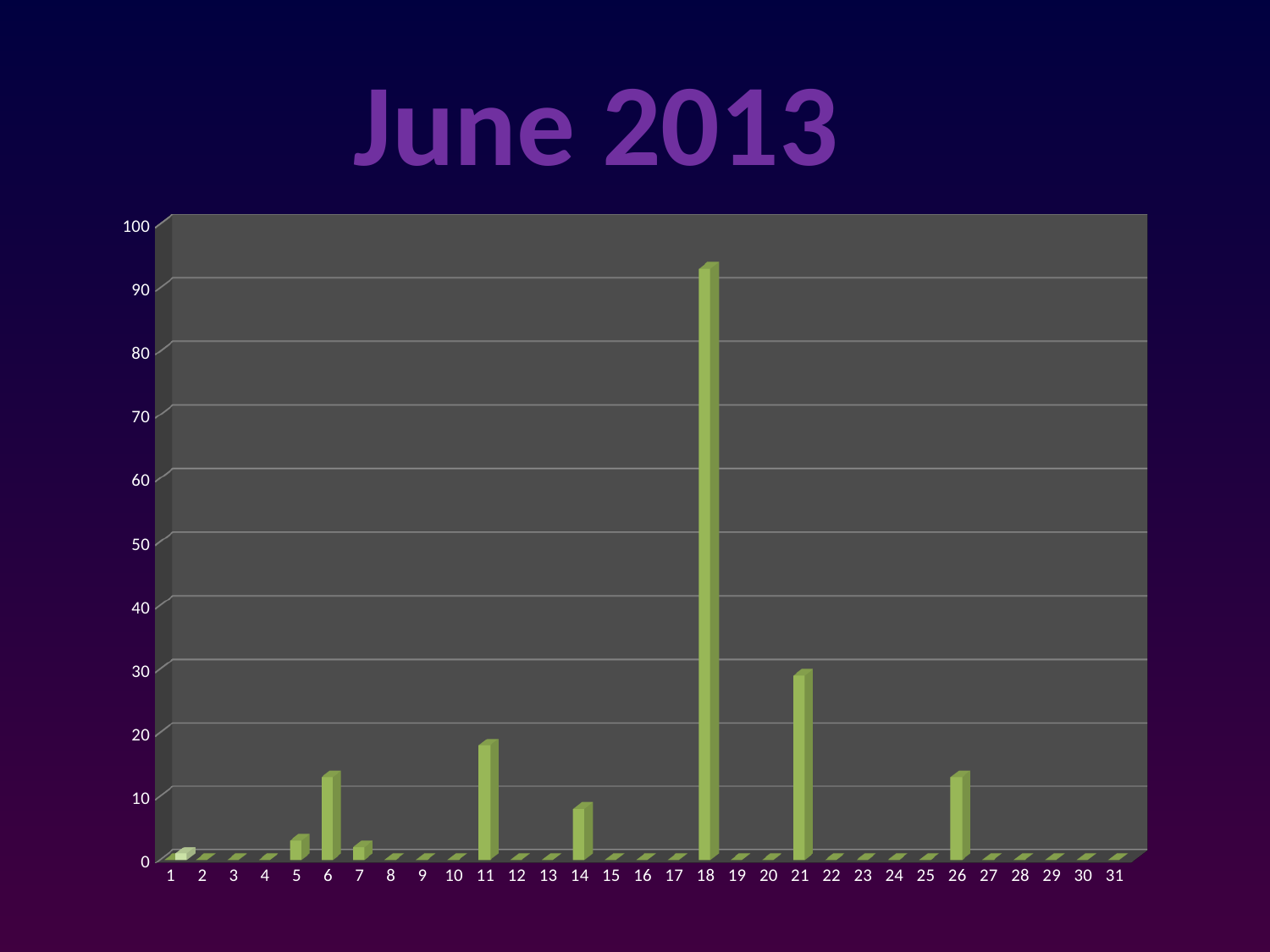
Is the value for category 18 greater or less than 80? greater Which is larger, the value for category 18 or the value for category 21? 18 Is the value for category 26 greater or less than 10? greater Which is larger, the value for category 11 or the value for category 6? 11 Is the value for category 11 greater or less than 10? greater Which category on the x axis has the highest bar? 18 How many categories are shown along the x axis? 31 What kind of chart is shown on the slide? bar chart Which is larger, the value for category 21 or the value for category 26? 21 What is the title shown above the chart? June 2013